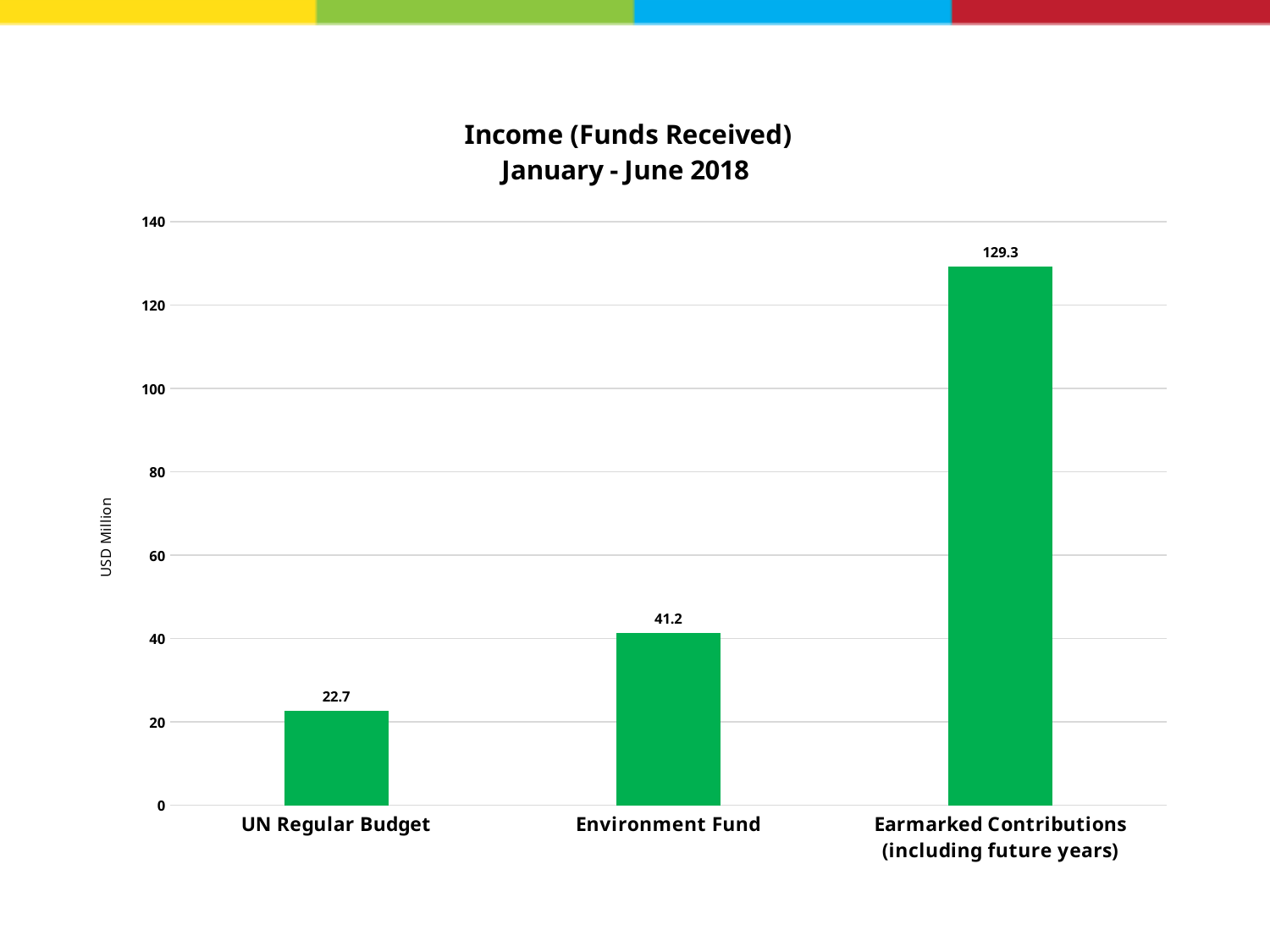
What kind of chart is shown on the slide? bar chart What is the value for UN Regular Budget? 22.7 What is the value for Earmarked Contributions (including future years)? 129.3 How many categories are shown on the chart? 3 What is the value for Environment Fund? 41.2 What is the difference between Environment Fund and UN Regular Budget? 18.5 What is the difference between Earmarked Contributions (including future years) and Environment Fund? 88.1 What is the label on the vertical axis? USD Million Which category has the highest value? Earmarked Contributions (including future years) Which is larger, Environment Fund or UN Regular Budget? Environment Fund Is the value for Earmarked Contributions (including future years) greater or less than 120? greater Which category has the lowest value? UN Regular Budget